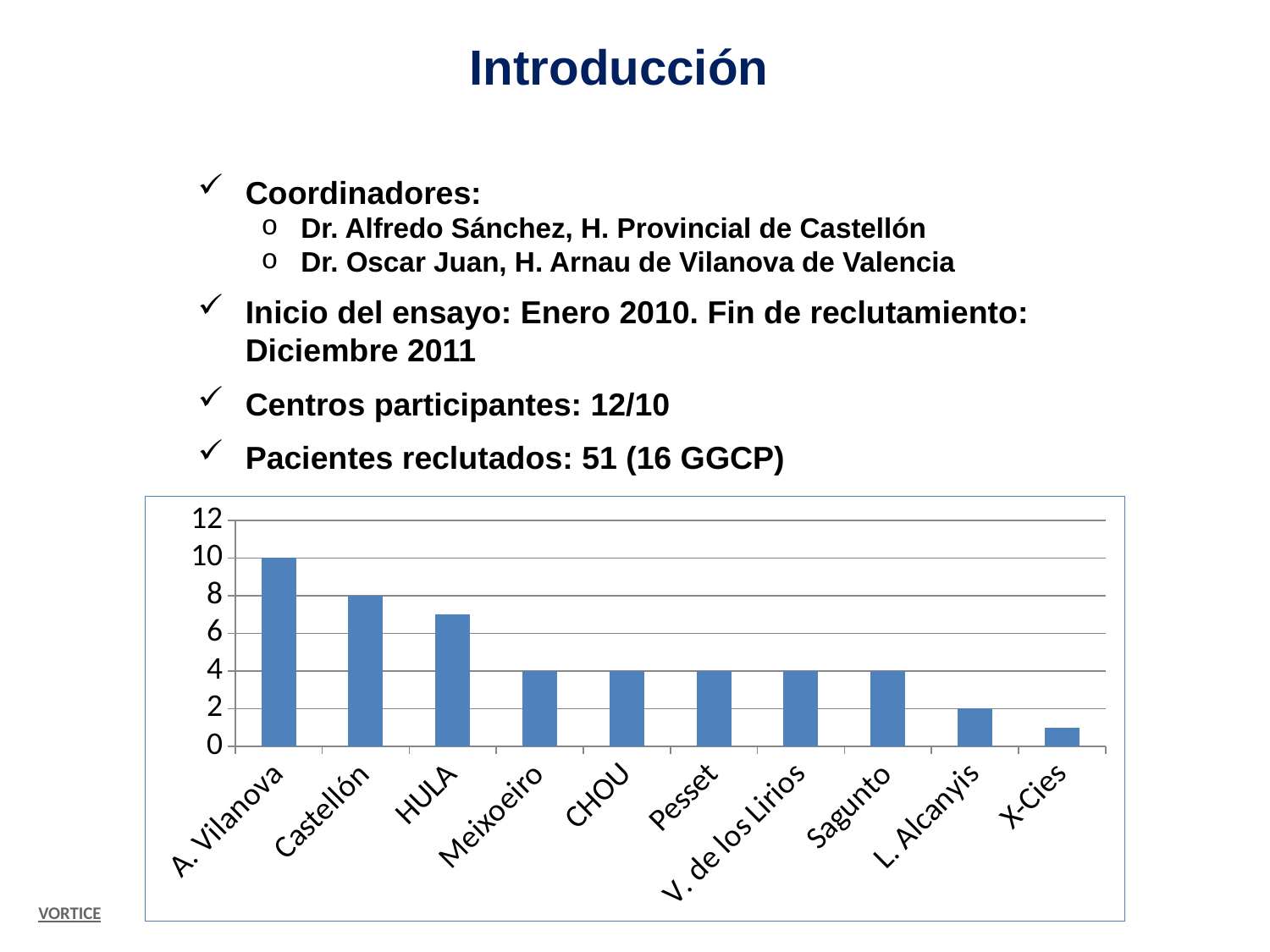
What is the value for A. Vilanova? 10 Which is larger, the value for Castellón or the value for Meixoeiro? Castellón What is the value for Castellón? 8 Is the value for X-Cies greater or less than 2? less Is the value for HULA greater or less than 6? greater What is the value for Sagunto? 4 What is the difference between the values for A. Vilanova and Castellón? 2 How many categories are shown on the x axis? 10 Which category has the highest value? A. Vilanova Which category has the lowest value? X-Cies What is the value for L. Alcanyis? 2 What kind of chart is shown on the slide? bar chart